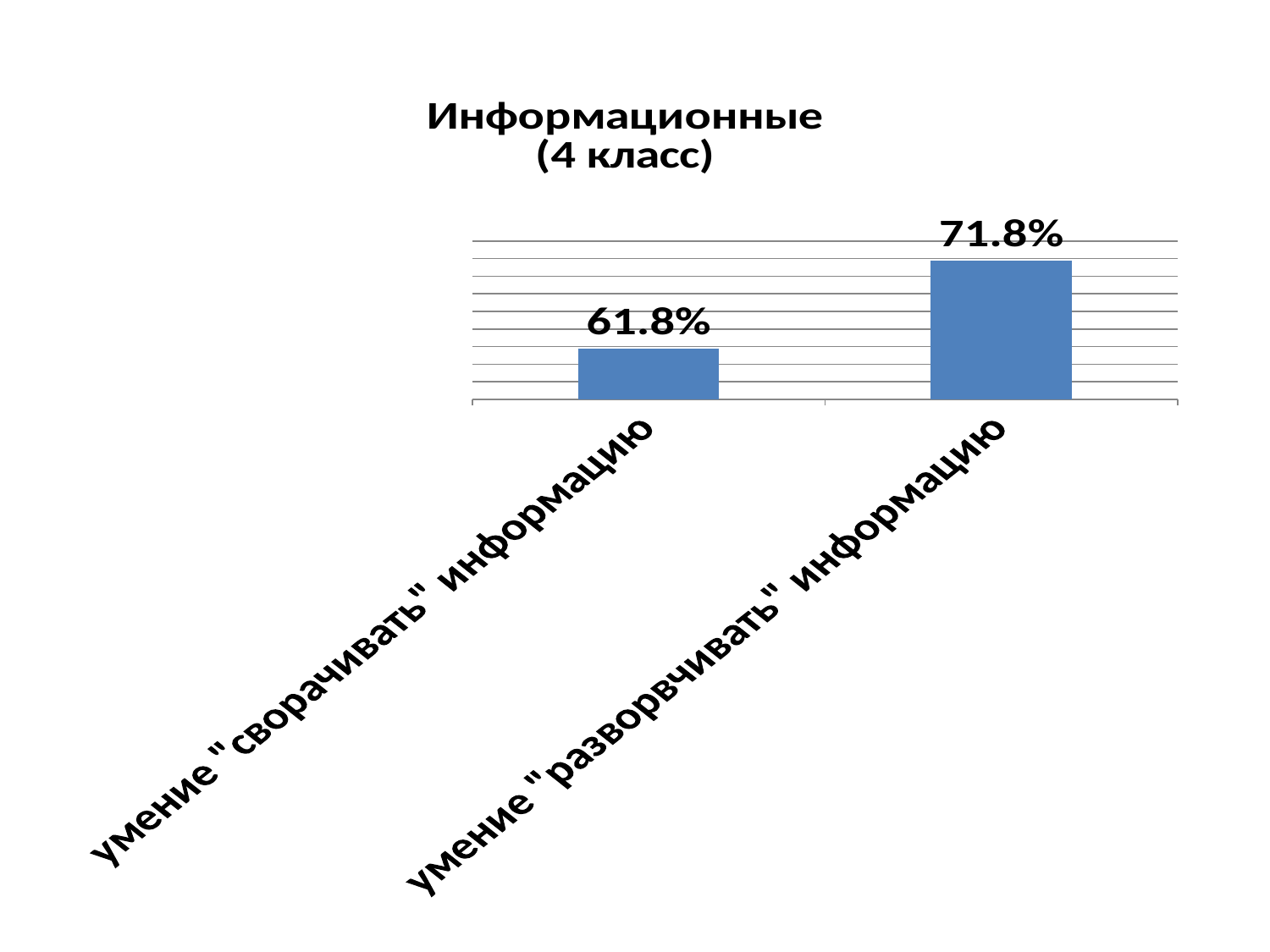
What is the value for умение "разворвчивать" информацию? 71.8% Which category has the highest value? умение "разворвчивать" информацию What is the value for умение "сворачивать" информацию? 61.8% Which is larger: the value for умение "сворачивать" информацию or the value for умение "разворвчивать" информацию? умение "разворвчивать" информацию What kind of chart is shown on the slide? bar chart What is the title of the chart? Информационные (4 класс) Do the values rise or fall from left to right along the x axis? rise Which category has the lowest value? умение "сворачивать" информацию How many categories are shown in the chart? 2 What is the difference between the values for умение "разворвчивать" информацию and умение "сворачивать" информацию? 10.0% What colour are the bars in the chart? blue